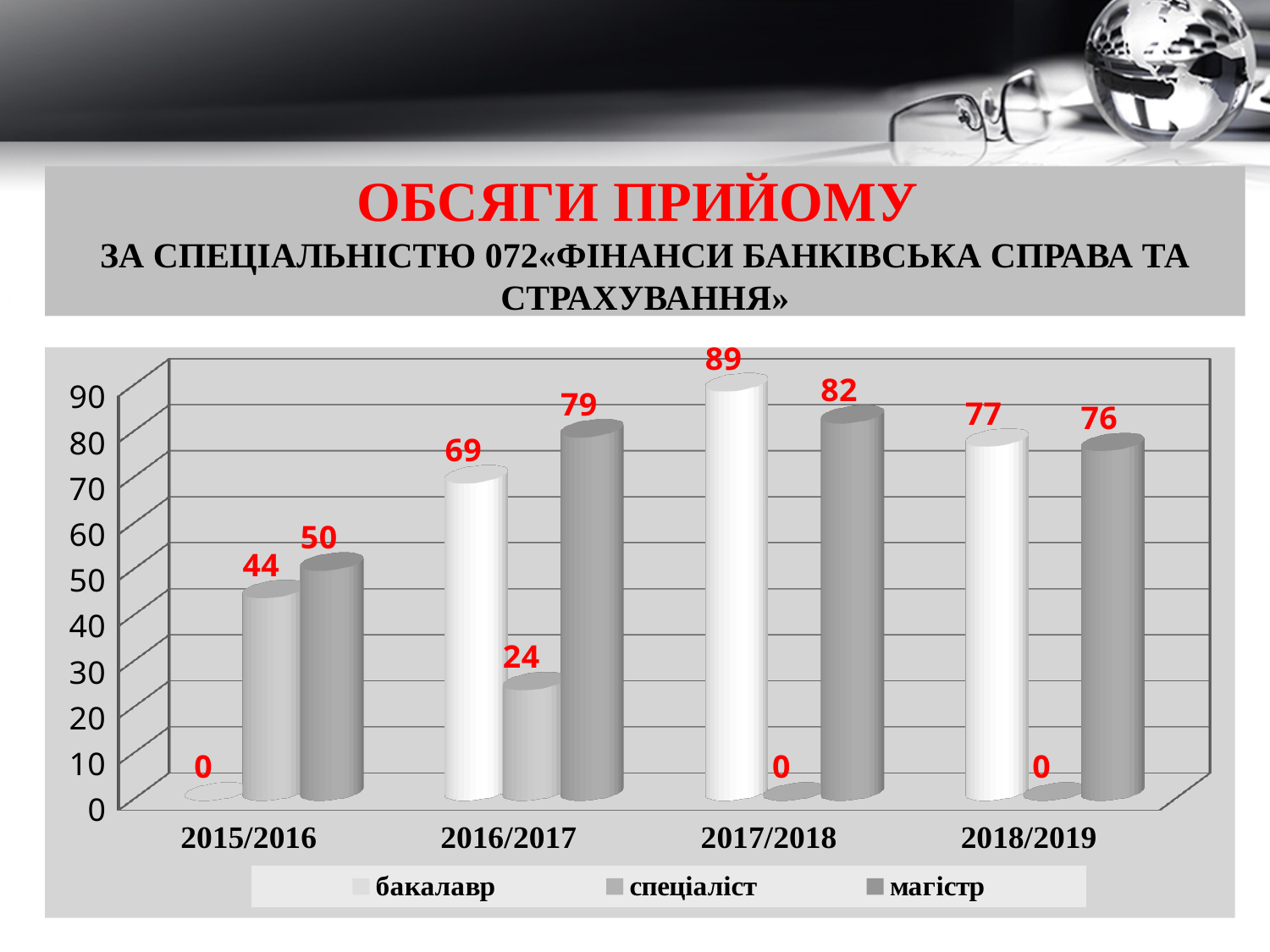
How many series does the legend list? 3 In which year is the бакалавр value highest? 2017/2018 What is the value for магістр in 2016/2017? 79 How many year categories are shown on the x axis? 4 What is the value for спеціаліст in 2015/2016? 44 Does the магістр value rise or fall from 2015/2016 to 2017/2018? rise What is the difference between the магістр and спеціаліст values in 2016/2017? 55 What is the value for спеціаліст in 2018/2019? 0 What kind of chart is shown on the slide? bar chart What is the value for бакалавр in 2017/2018? 89 In which year is the магістр value lowest? 2015/2016 Which is larger in 2018/2019, бакалавр or магістр? бакалавр